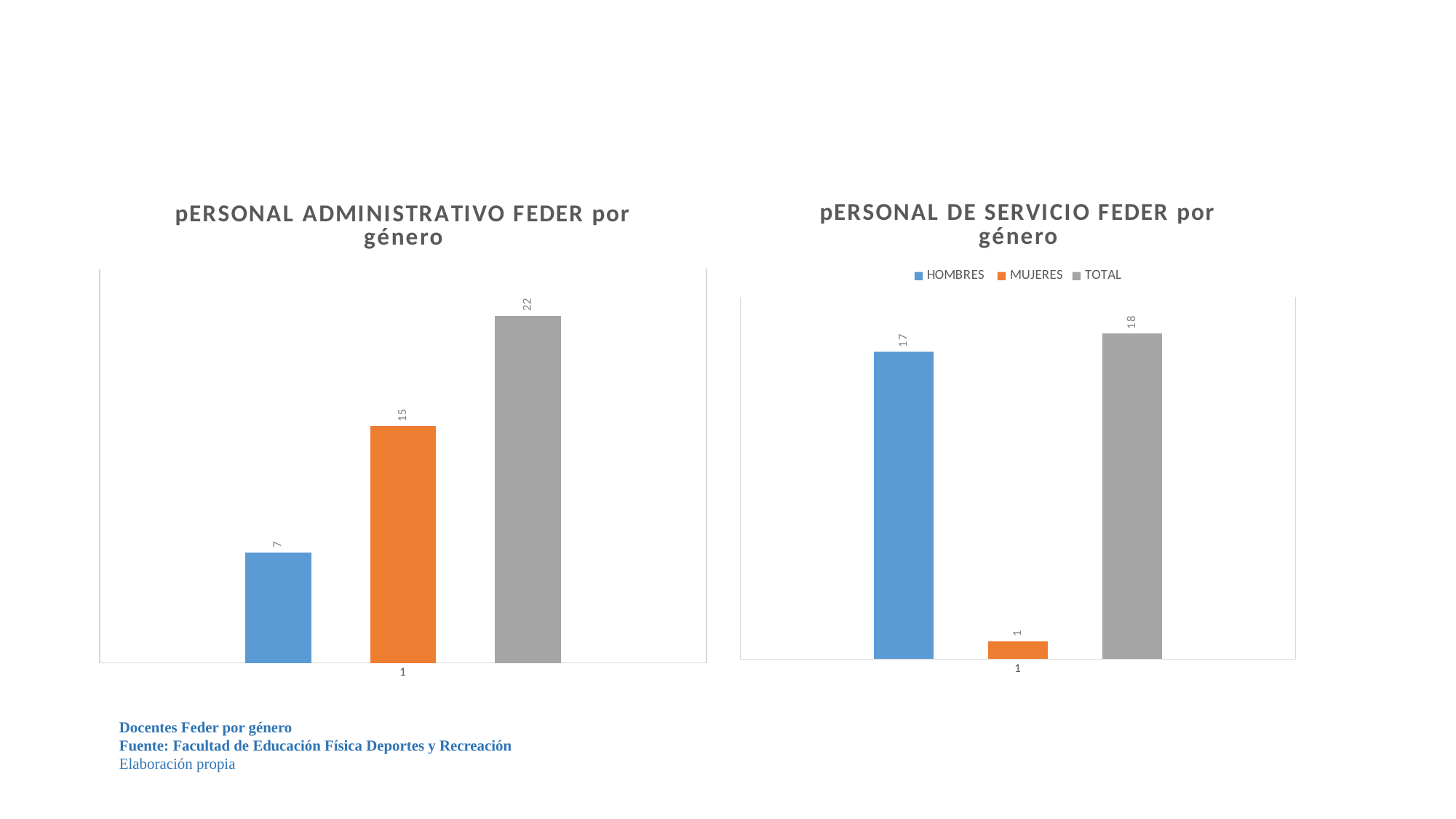
In the 'pERSONAL ADMINISTRATIVO FEDER por género' chart, what is the value of the grey bar? 22 In the 'pERSONAL DE SERVICIO FEDER por género' chart, which series has the lowest value? MUJERES In the 'pERSONAL ADMINISTRATIVO FEDER por género' chart, what is the difference between the orange bar and the blue bar? 8 In the 'pERSONAL ADMINISTRATIVO FEDER por género' chart, what is the value of the blue bar? 7 In the 'pERSONAL ADMINISTRATIVO FEDER por género' chart, which is larger, the blue bar or the orange bar? the orange bar In the 'pERSONAL DE SERVICIO FEDER por género' chart, what is the value for TOTAL? 18 In the 'pERSONAL DE SERVICIO FEDER por género' chart, how many series does the legend list? 3 In the 'pERSONAL DE SERVICIO FEDER por género' chart, what is the difference between HOMBRES and MUJERES? 16 What kind of chart is the 'pERSONAL DE SERVICIO FEDER por género' chart? bar chart In the 'pERSONAL DE SERVICIO FEDER por género' chart, what is the value for HOMBRES? 17 In the 'pERSONAL DE SERVICIO FEDER por género' chart, what is the value for MUJERES? 1 In the 'pERSONAL ADMINISTRATIVO FEDER por género' chart, what is the value of the orange bar? 15